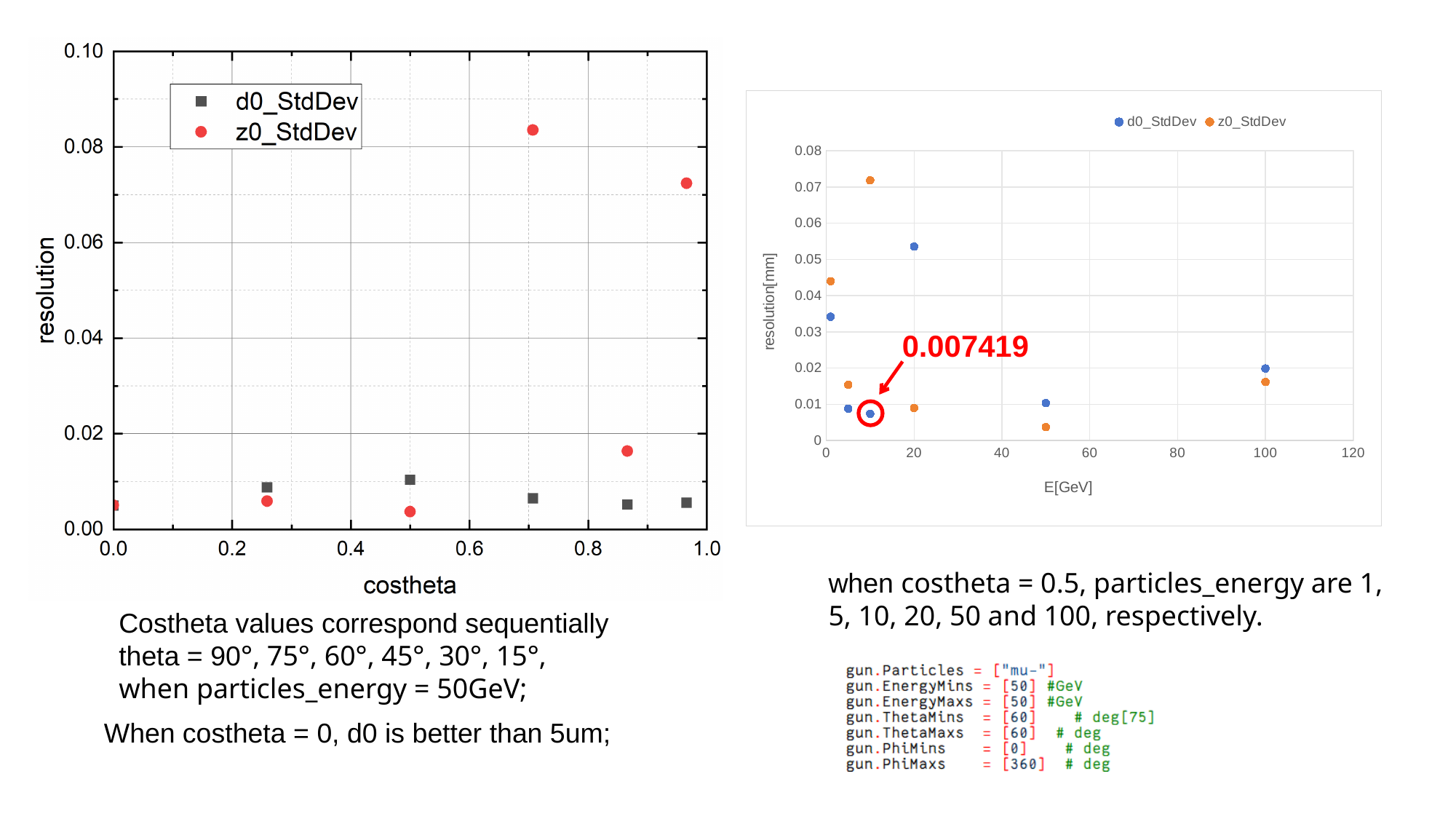
What kind of chart is the left chart (resolution vs costheta)? scatter chart In the left chart, which series is plotted with red circles? z0_StdDev In the right chart, is the z0_StdDev value at E = 10 GeV greater or less than 0.06? greater In the right chart, at E = 1 GeV, which series has the larger value, d0_StdDev or z0_StdDev? z0_StdDev In the left chart, how many data points are plotted for the z0_StdDev series? 6 In the right chart (resolution vs E[GeV]), what is the labelled d0_StdDev value at E = 10 GeV? 0.007419 How many series does the legend of the left chart list? 2 In the left chart, at costheta 0.5, which series has the larger value, d0_StdDev or z0_StdDev? d0_StdDev In the left chart, at costheta 0.7, which series has the larger value, d0_StdDev or z0_StdDev? z0_StdDev In the right chart, at which energy is the z0_StdDev value highest? 10 GeV In the left chart, is the z0_StdDev value at costheta 0.7 greater or less than 0.06? greater In the right chart, at which energy is the d0_StdDev value highest? 20 GeV